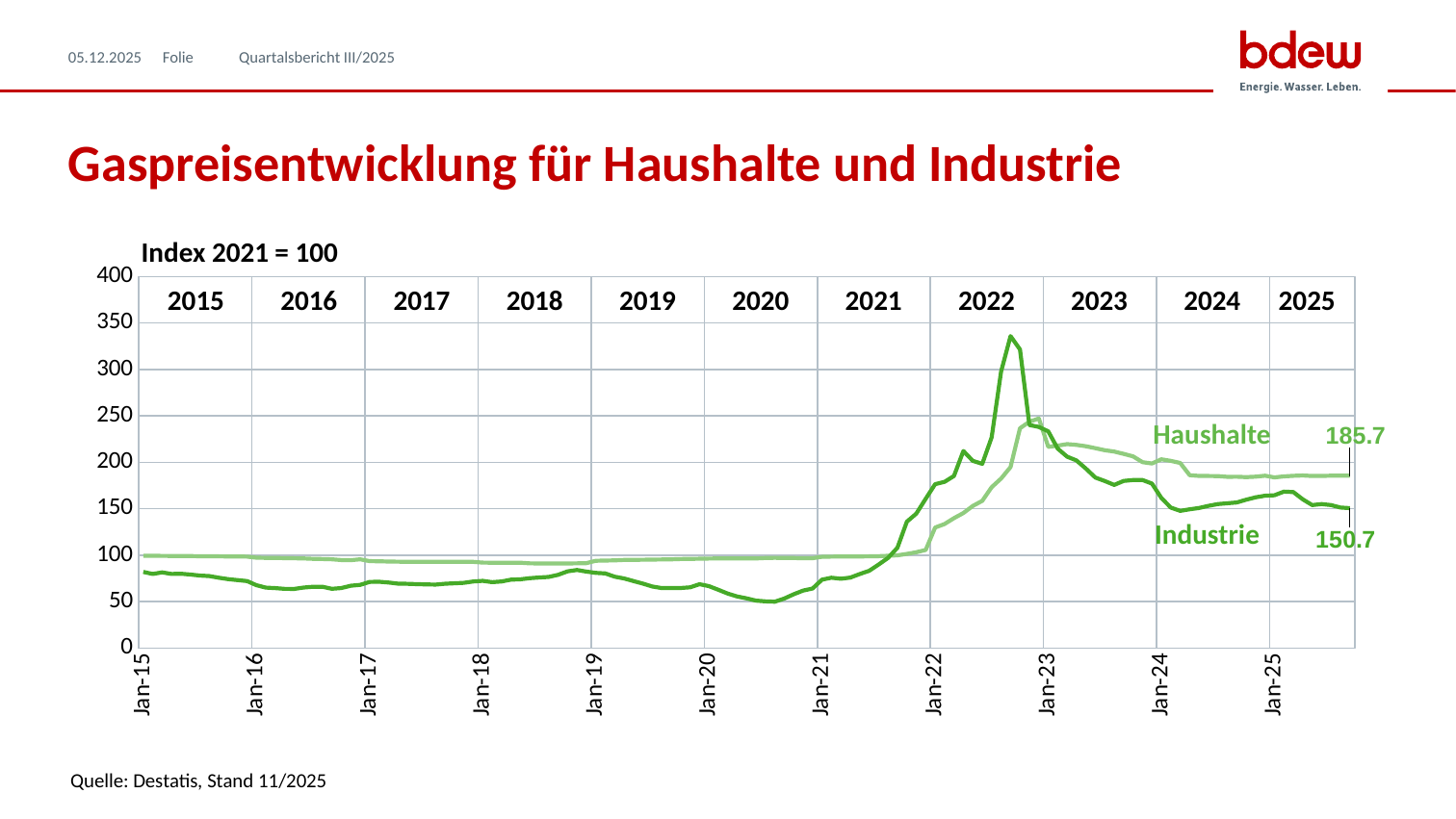
Is the value for Industrie in Jan-20 greater or less than 100? less What is the latest value shown for Haushalte? 185.7 Does the Industrie series rise or fall between Jan-21 and its peak in 2022? rise What is the latest value shown for Industrie? 150.7 What is the difference between the latest Haushalte value and the latest Industrie value? 35.0 Which series reaches the highest peak in the chart? Industrie Is the peak value of the Industrie series in 2022 greater or less than 300? greater How many series are plotted in the chart? 2 What is the title of the chart on the slide? Gaspreisentwicklung für Haushalte und Industrie What kind of chart is shown on the slide? line chart Which series has the higher latest value, Haushalte or Industrie? Haushalte Which year is the base year of the index (= 100) in the chart? 2021